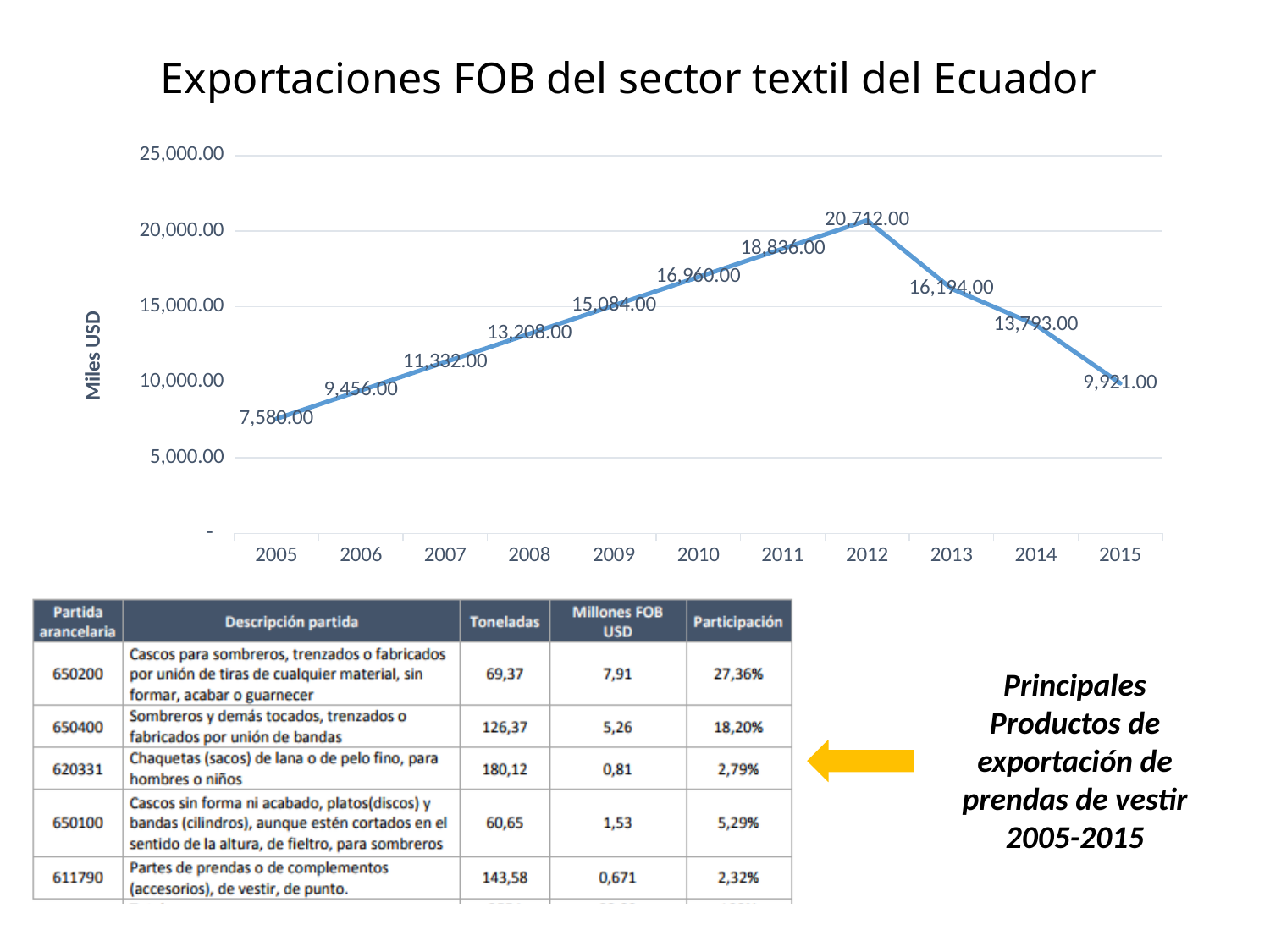
Which year has the lowest value? 2005 Which is larger, the value for 2006 or the value for 2015? 2015 Is the value for 2014 greater or less than 15,000.00? less What is the difference between the values for 2012 and 2013? 4,518.00 What type of chart is shown on the slide? line chart Do the values rise or fall from 2005 to 2012? rise What is the value for 2005? 7,580.00 What is the value for 2015? 9,921.00 How many years are plotted on the x axis? 11 What is the value for 2012? 20,712.00 Which year has the highest value? 2012 What is the value for 2009? 15,084.00